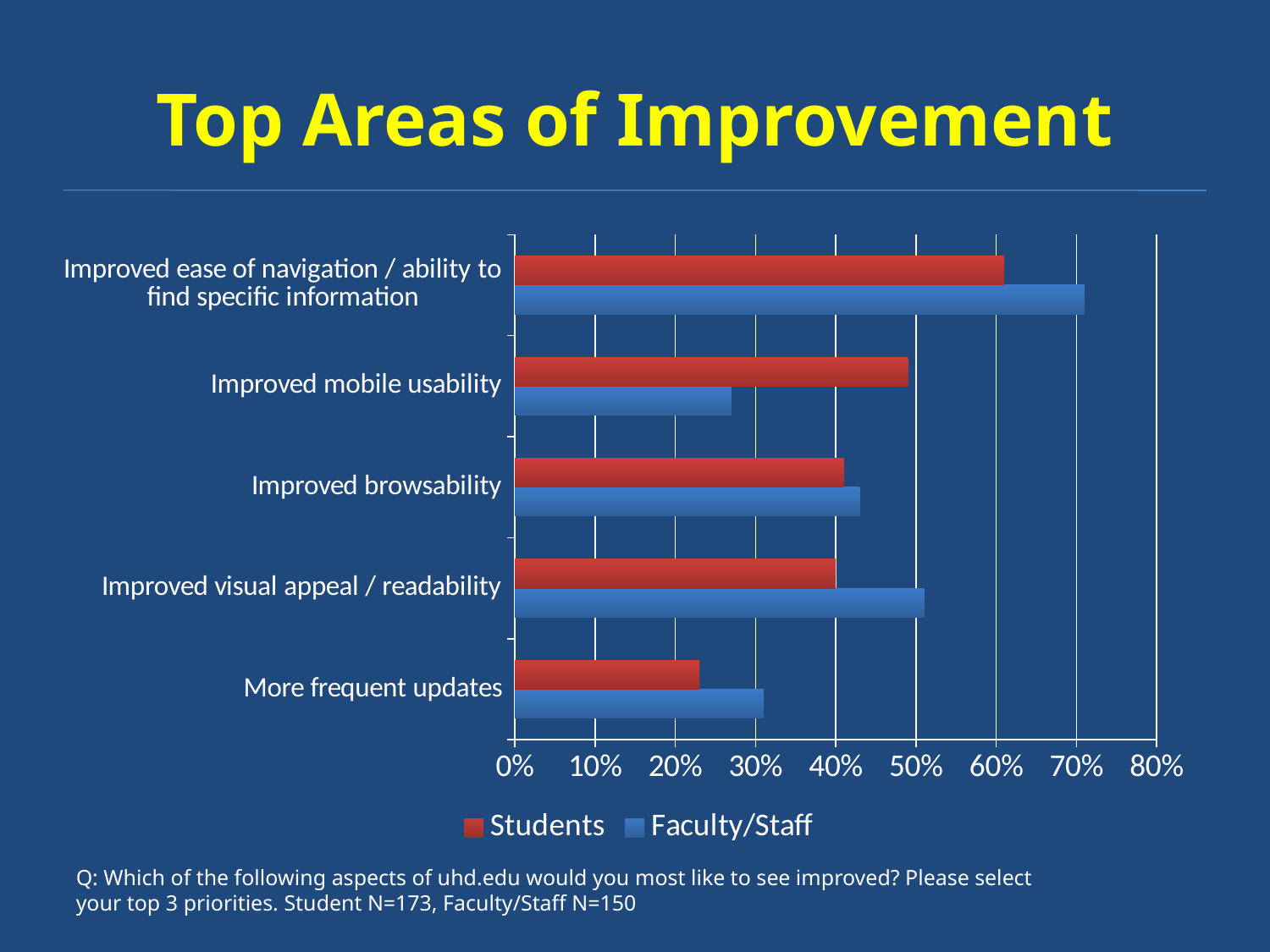
Which category has the lowest Students value? More frequent updates Which category has the highest Faculty/Staff value? Improved ease of navigation / ability to find specific information How many categories are shown on the chart? 5 What kind of chart is shown on the slide? Bar chart Is the Faculty/Staff value for Improved mobile usability greater or less than 30%? less For Improved visual appeal / readability, which is larger: the Students value or the Faculty/Staff value? Faculty/Staff What is the title of the chart on the slide? Top Areas of Improvement For Improved mobile usability, which is larger: the Students value or the Faculty/Staff value? Students Is the Students value for Improved mobile usability greater or less than 40%? greater Which category has the lowest Faculty/Staff value? Improved mobile usability How many series does the legend list? 2